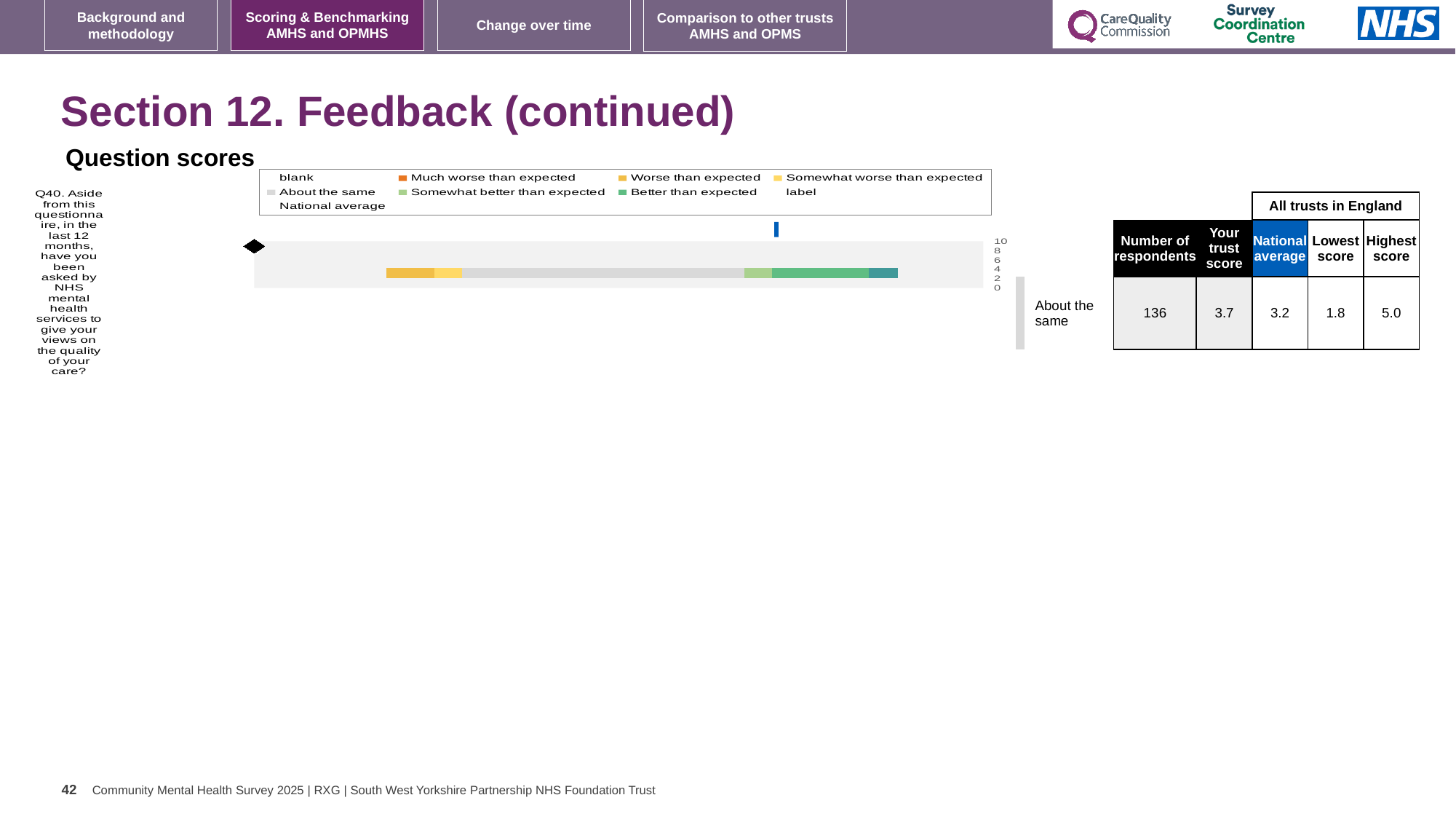
What kind of chart is used to show the Q40 question score? bar chart For Q40, which is larger: the trust score or the national average? the trust score What colour does the legend use for 'Much worse than expected'? orange How many questions are plotted in the question scores chart? 1 For Q40, what is the difference between the trust score and the national average? 0.5 What is the highest score among all trusts in England for Q40? 5.0 How many respondents answered Q40 according to the table beside the chart? 136 What is the national average score for Q40 shown in the table beside the chart? 3.2 What colour does the legend use for 'Better than expected'? green How many entries does the legend of the question scores chart list? 9 What is the trust score for Q40 shown in the table beside the chart? 3.7 What is the lowest score among all trusts in England for Q40? 1.8